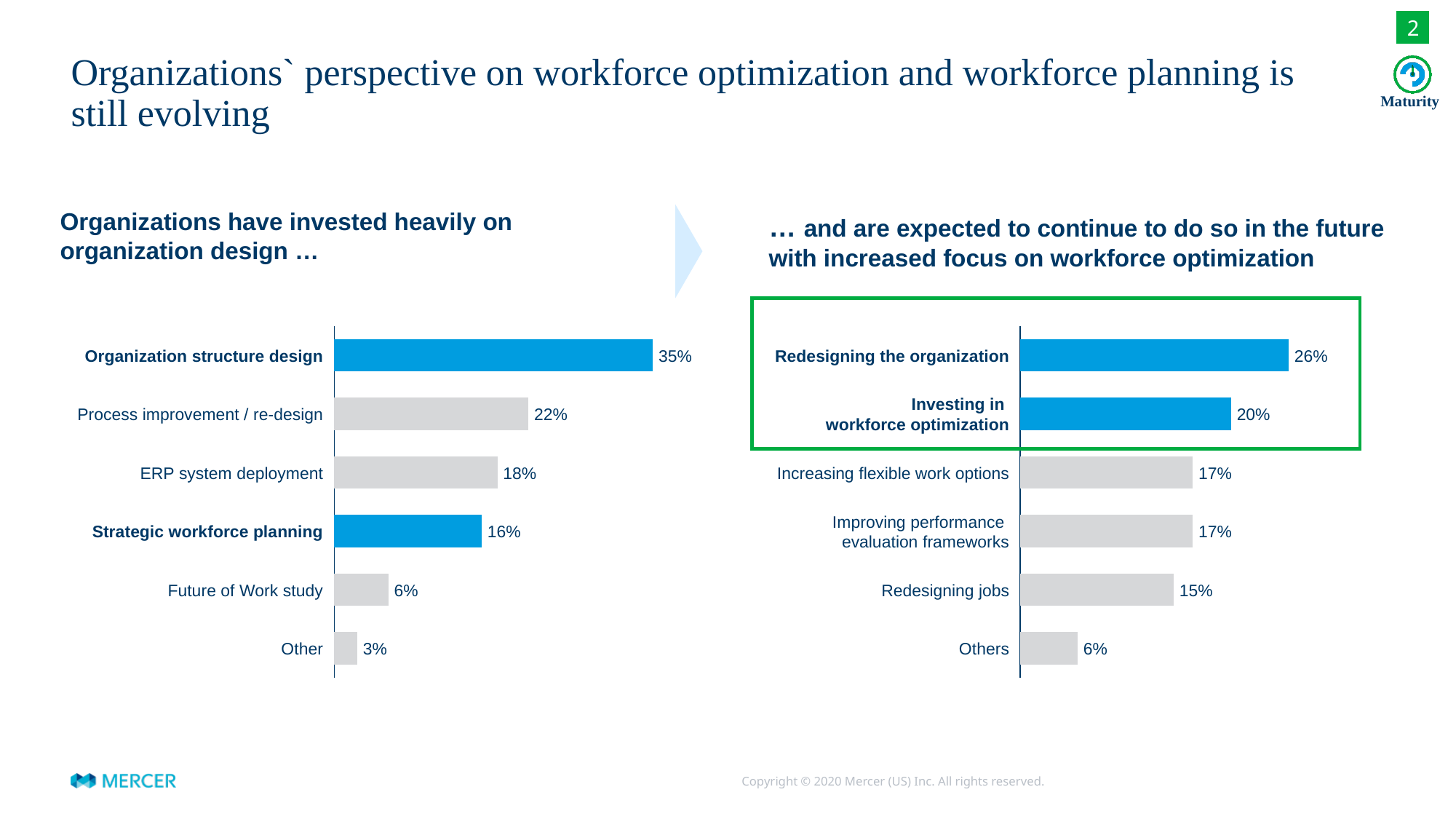
In the right chart, what is the value for Redesigning jobs? 15% In the left chart, which is larger: ERP system deployment or Future of Work study? ERP system deployment In the left chart, what is the difference between Organization structure design and Process improvement / re-design? 13% What kind of chart is the left chart? Bar chart In the right chart, which two categories are highlighted with a green box? Redesigning the organization and Investing in workforce optimization How many categories are shown in the right chart? 6 In the left chart, what is the value for Strategic workforce planning? 16% In the left chart, which category has the highest value? Organization structure design In the right chart, what is the difference between Redesigning the organization and Investing in workforce optimization? 6% In the right chart, which category has the lowest value? Others In the right chart, what is the value for Investing in workforce optimization? 20% In the left chart, what is the value for Organization structure design? 35%